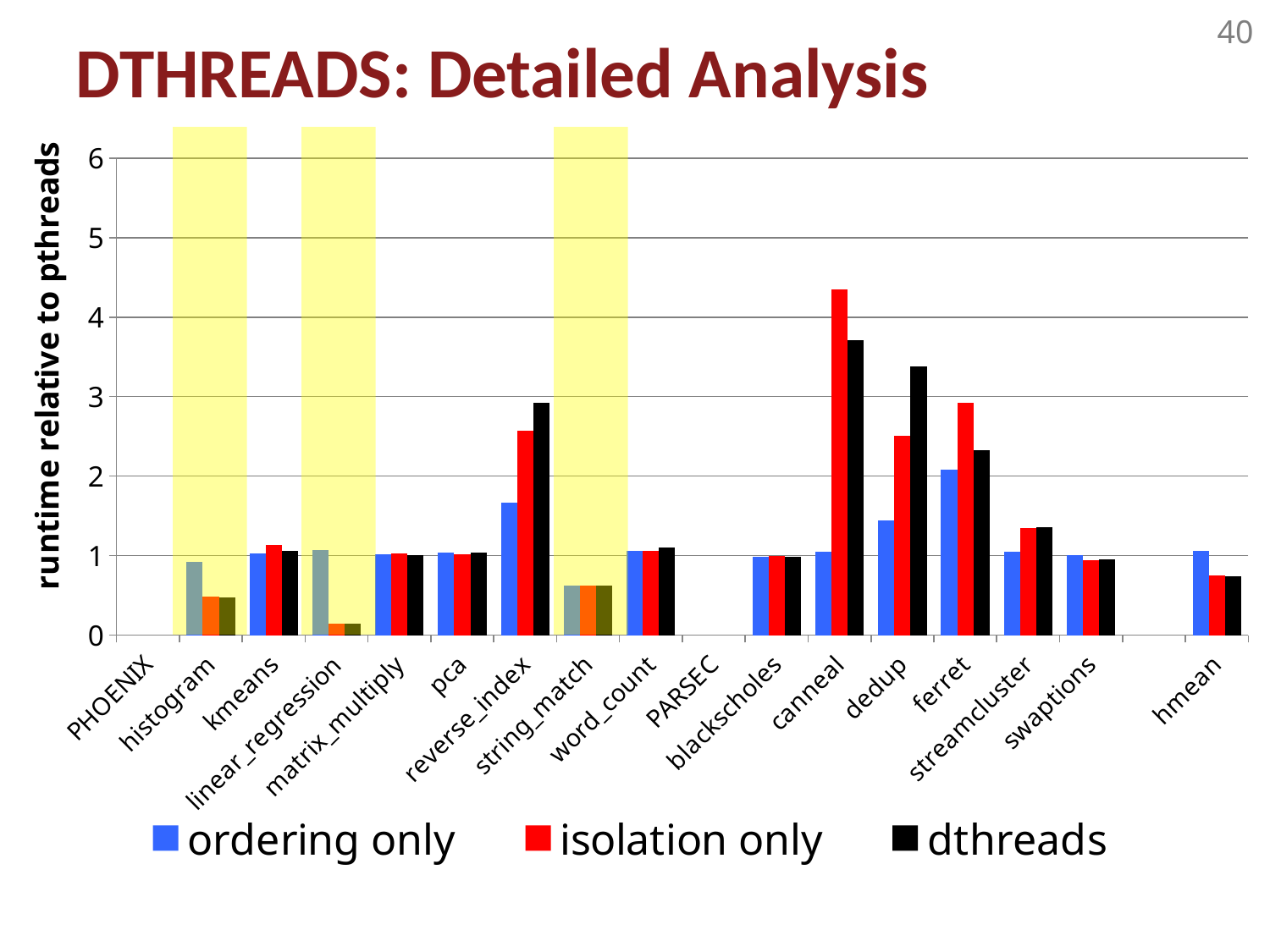
What is the label of the y axis? runtime relative to pthreads Which colour represents the dthreads series in the legend? black For ferret, which is larger: the isolation only value or the dthreads value? isolation only For which benchmark is the isolation only value lowest? linear_regression Is the dthreads value for dedup greater or less than 3? greater What kind of chart is shown on the slide? bar chart For which benchmark is the dthreads value highest? canneal For dedup, which is larger: the isolation only value or the dthreads value? dthreads Is the isolation only value for canneal greater or less than 4? greater For which benchmark is the isolation only value highest? canneal How many series does the legend list? 3 Is the ordering only value for reverse_index greater or less than 2? less